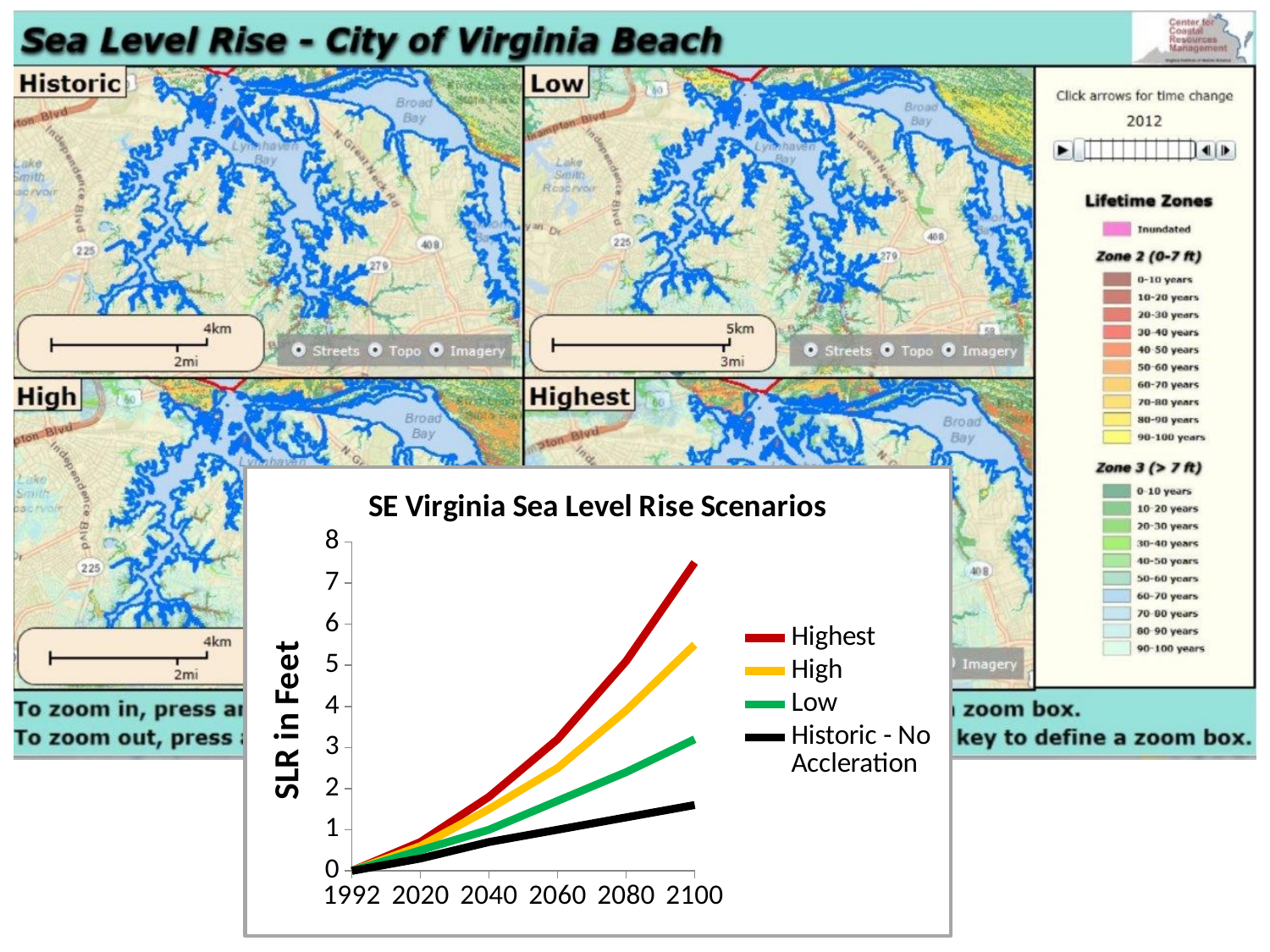
What is the y-axis label of the "SE Virginia Sea Level Rise Scenarios" chart? SLR in Feet In the "SE Virginia Sea Level Rise Scenarios" chart, which scenario has the lowest value in 2100? Historic - No Accleration In the "SE Virginia Sea Level Rise Scenarios" chart, what colour is the line for the Low scenario? green In the "SE Virginia Sea Level Rise Scenarios" chart, is the value for the Historic - No Accleration scenario in 2100 greater or less than 2? less In the "SE Virginia Sea Level Rise Scenarios" chart, which is larger in 2080: the High scenario or the Low scenario? High In the "SE Virginia Sea Level Rise Scenarios" chart, is the value for the High scenario in 2100 greater or less than 6? less How many series does the legend of the "SE Virginia Sea Level Rise Scenarios" chart list? 4 What kind of chart is the "SE Virginia Sea Level Rise Scenarios" chart? line chart In the "SE Virginia Sea Level Rise Scenarios" chart, is the value for the Highest scenario in 2100 greater or less than 7? greater In the "SE Virginia Sea Level Rise Scenarios" chart, which scenario has the highest value in 2100? Highest In the "SE Virginia Sea Level Rise Scenarios" chart, do the values of the Highest scenario rise or fall from 1992 to 2100? rise